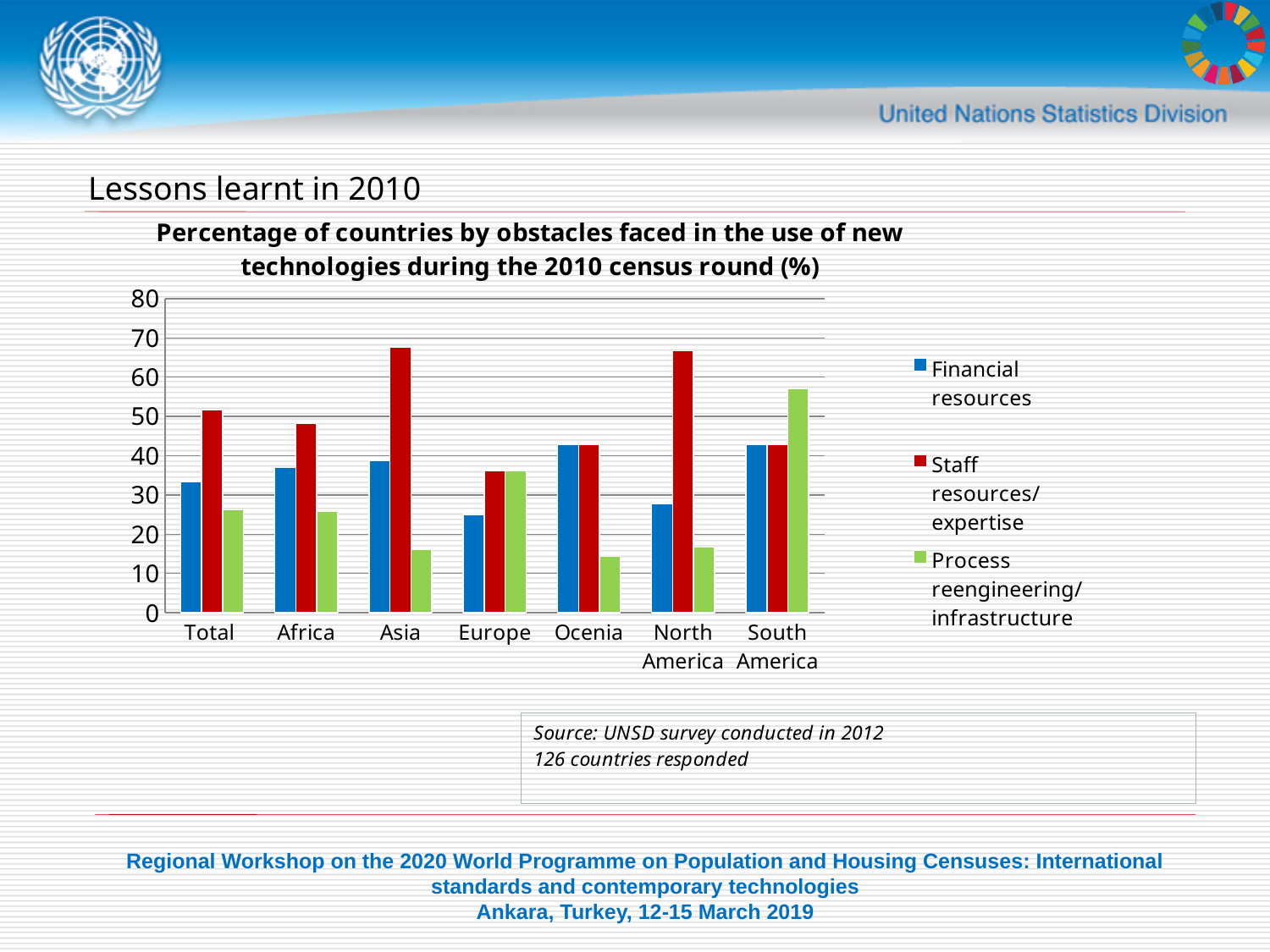
Which category has the highest value for Process reengineering/infrastructure? South America How many categories are shown on the x axis? 7 How many series does the legend list? 3 Is the value for Process reengineering/infrastructure in Ocenia greater or less than 20? less In South America, which is larger: Financial resources or Process reengineering/infrastructure? Process reengineering/infrastructure What kind of chart is shown on the slide? bar chart What colour represents Staff resources/expertise in the chart? red In Asia, which is larger: Financial resources or Staff resources/expertise? Staff resources/expertise Is the value for Staff resources/expertise in Asia greater or less than 60? greater Is the value for Financial resources in Europe greater or less than 30? less